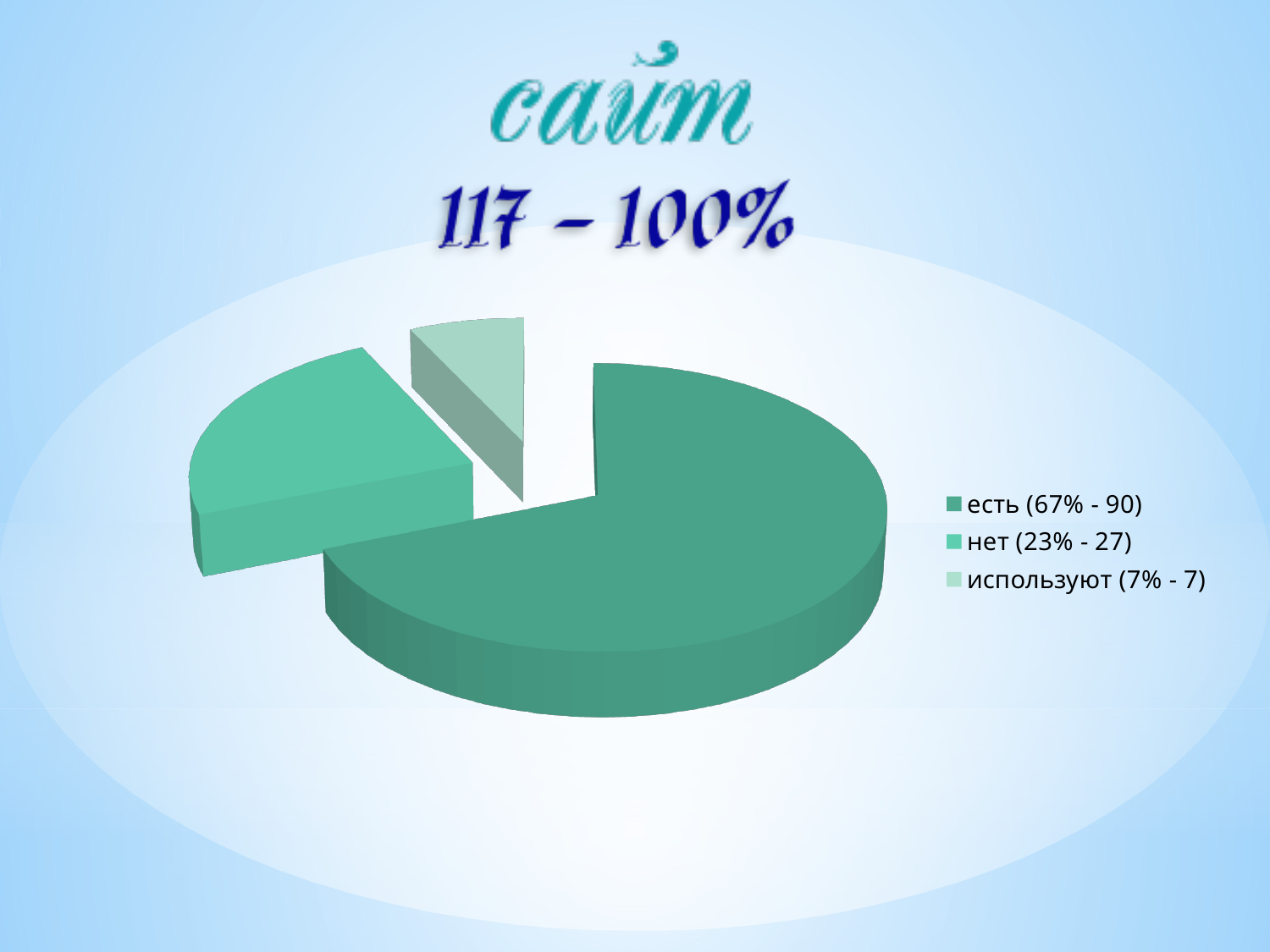
What is the difference in count between "есть" and "нет"? 63 What share of the pie does the slice "используют" represent? 7% Which is larger, the slice for "нет" or the slice for "используют"? нет What kind of chart is shown on the slide? pie chart How many items does the legend give for the category "есть"? 90 What total number and percentage are shown in the title above the chart? 117 – 100% Which category has the largest slice of the pie? есть What share of the pie does the slice "нет" represent? 23% What share of the pie does the slice "есть" represent? 67% How many slices does the pie chart have? 3 Which category has the smallest slice of the pie? используют How many items does the legend give for the category "нет"? 27